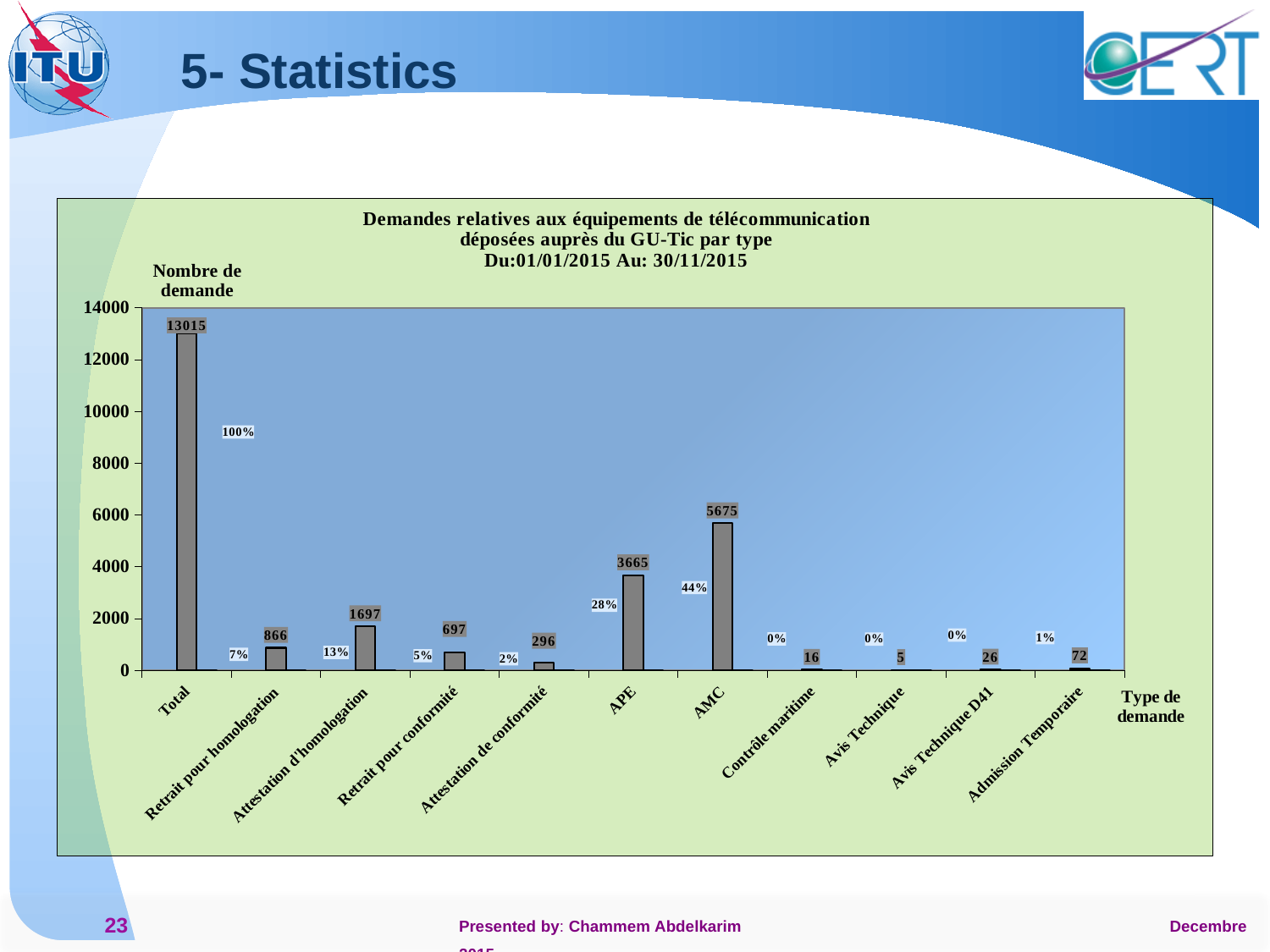
What percentage is shown for APE? 28% Which category has the lowest number of requests? Avis Technique What is the number of requests for Attestation d'homologation? 1697 What is the value for Admission Temporaire? 72 Which is larger, the value for Retrait pour homologation or Retrait pour conformité? Retrait pour homologation Excluding Total, which category has the highest number of requests? AMC How many categories are shown on the x axis? 11 What is the difference between the values for AMC and APE? 2010 What value is shown for Total? 13015 What kind of chart is shown on the slide? Bar chart What is the number of requests for AMC? 5675 What is the label of the vertical axis? Nombre de demande